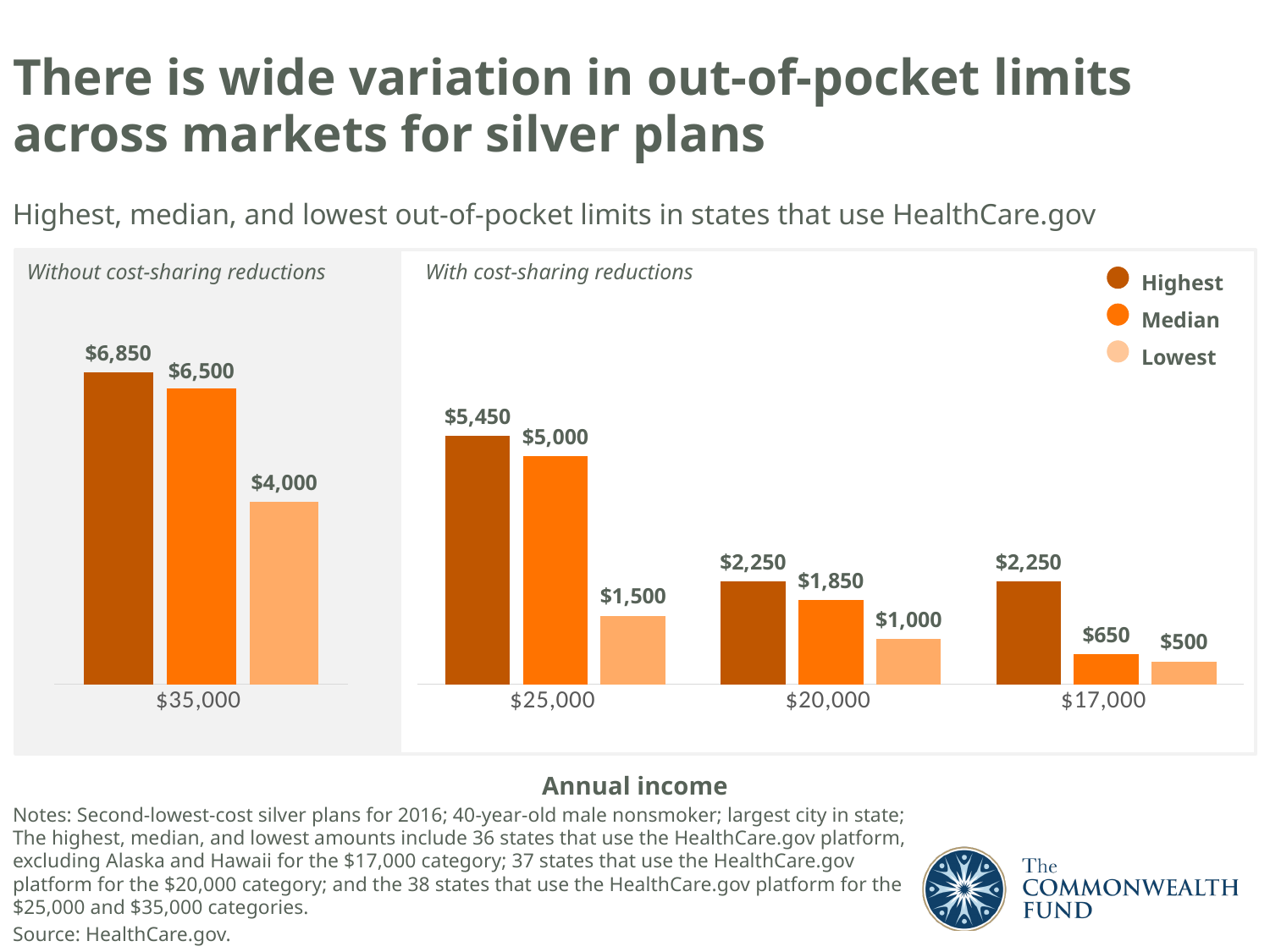
What kind of chart is shown on the slide? Bar chart How many series does the legend list? 3 What is the lowest out-of-pocket limit for the $20,000 annual income category? $1,000 What is the lowest out-of-pocket limit for the $17,000 annual income category? $500 Which is larger: the median limit for the $20,000 category or the highest limit for the $17,000 category? The highest limit for the $17,000 category What is the median out-of-pocket limit for the $25,000 annual income category? $5,000 What is the difference between the highest and lowest out-of-pocket limits for the $35,000 category? $2,850 What is the difference between the median out-of-pocket limits for the $25,000 and $20,000 categories? $3,150 How many annual income categories are shown on the chart? 4 Which annual income category has the highest value for the Highest series? $35,000 What is the highest out-of-pocket limit for the $35,000 annual income category? $6,850 Which annual income category has the lowest value for the Median series? $17,000